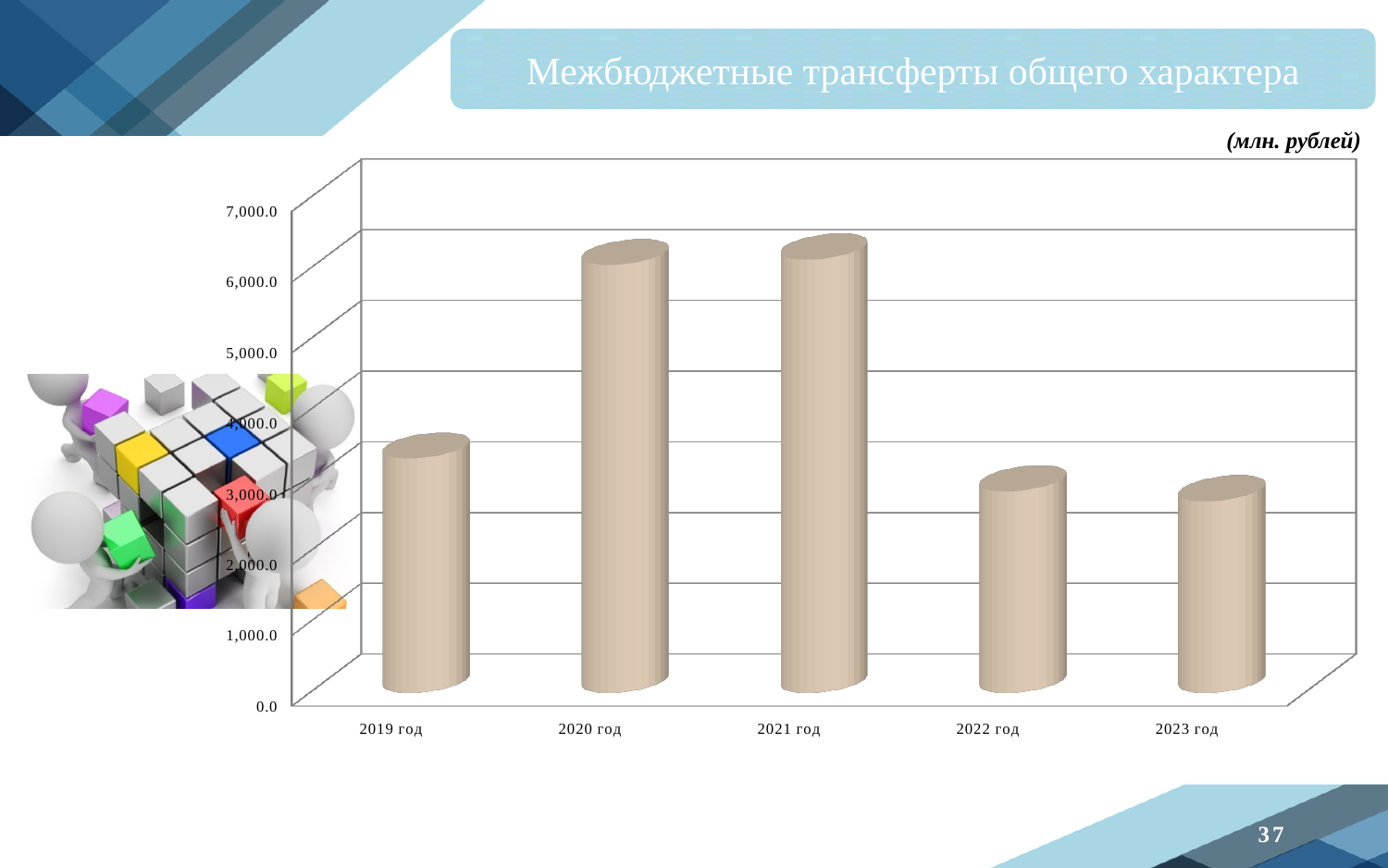
What kind of chart is shown on the slide? bar chart Is the value for 2020 год greater or less than 5,000.0? greater Do the values rise or fall from 2021 год to 2023 год? fall Which is larger, the value for 2021 год or the value for 2022 год? 2021 год Which is larger, the value for 2019 год or the value for 2023 год? 2019 год Is the value for 2021 год greater or less than 5,000.0? greater Is the value for 2023 год greater or less than 2,000.0? greater How many years (categories) are shown on the x axis of the chart? 5 In what units are the values on the chart given, according to the slide? млн. рублей Which is larger, the value for 2020 год or the value for 2019 год? 2020 год